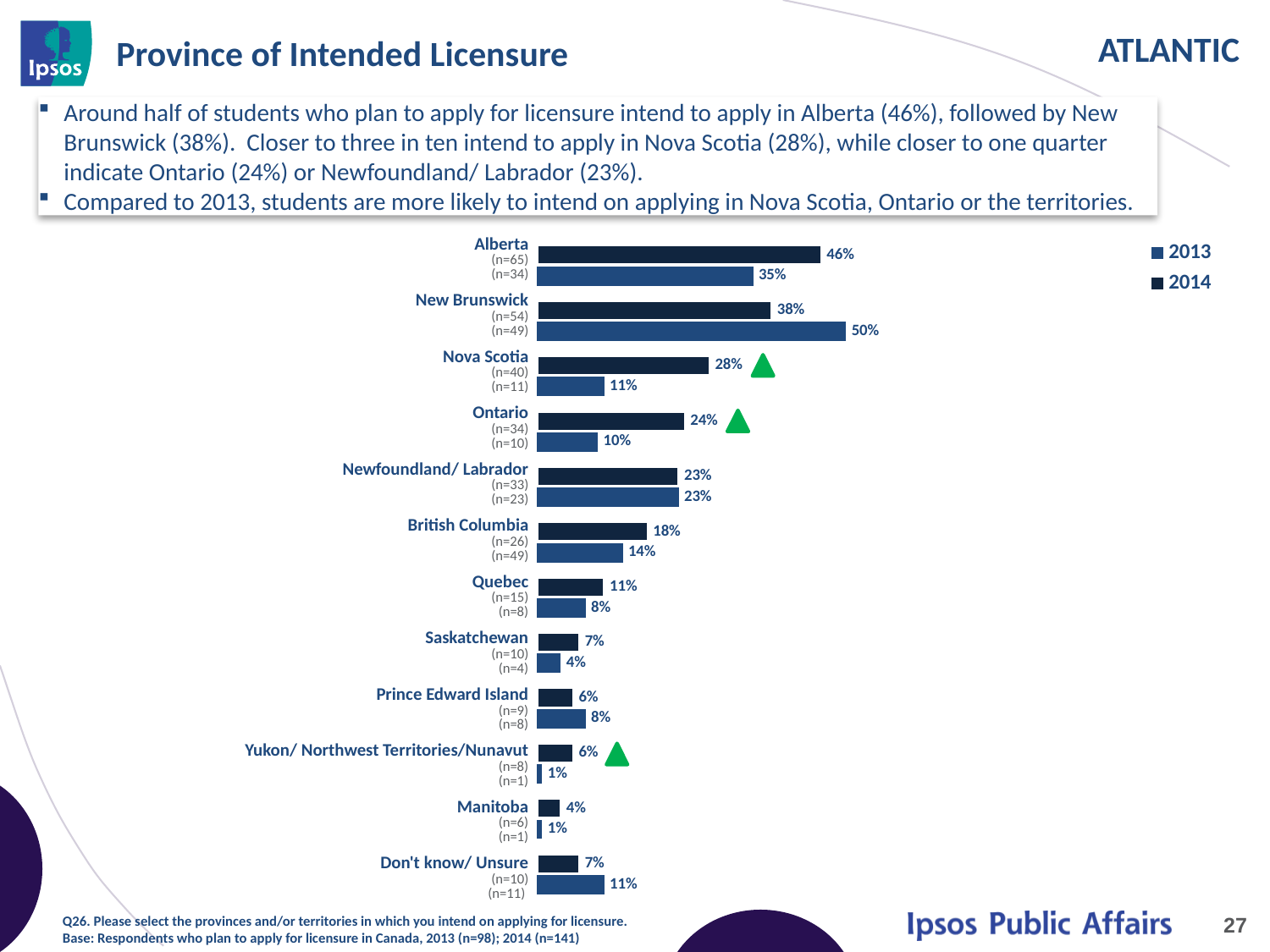
Which category has the single longest bar on the chart? New Brunswick What is the value of the lower bar for Manitoba? 1% What value is shown for both bars of Newfoundland/ Labrador? 23% How many categories (provinces/territories plus Don't know) are shown on the chart? 12 What is the difference between the upper bar (24%) and the lower bar (10%) for Ontario? 14 percentage points How many series does the chart legend list? 2 Which is larger: the upper bar for Alberta or the upper bar for New Brunswick? Alberta What are the two entries in the chart legend? 2013 and 2014 What is the value of the lower bar for New Brunswick? 50% What kind of chart is shown on the slide? Bar chart What is the difference between the upper bar (28%) and the lower bar (11%) for Nova Scotia? 17 percentage points What is the value of the upper bar for Alberta? 46%